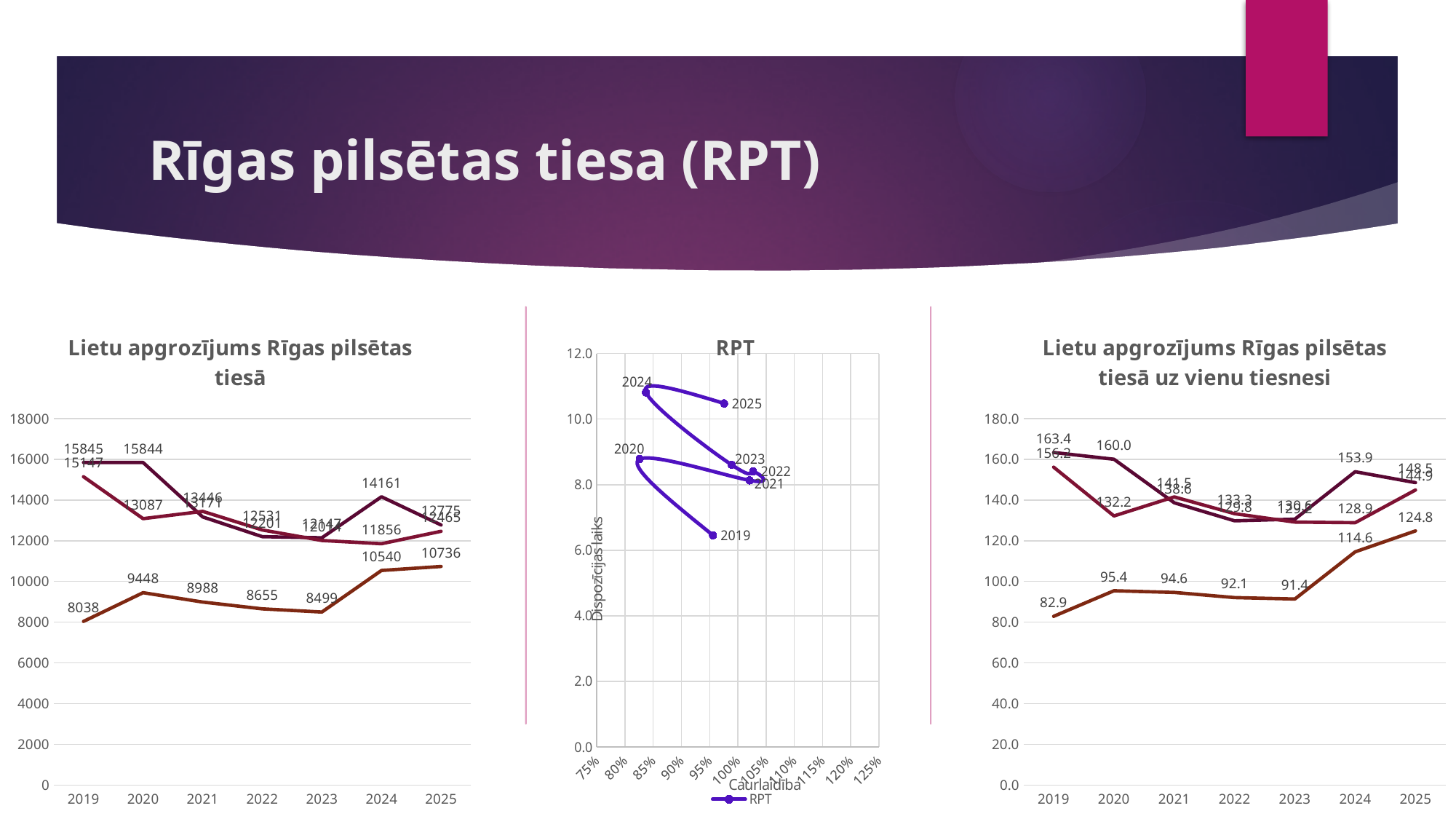
In the right chart 'Lietu apgrozījums Rīgas pilsētas tiesā uz vienu tiesnesi', what is the value of the lowest line in 2025? 124.8 In the middle chart 'RPT', which year has the lowest Dispozīcijas laiks value? 2019 In the right chart 'Lietu apgrozījums Rīgas pilsētas tiesā uz vienu tiesnesi', is the lowest line's value larger in 2019 or in 2020? 2020 How many series does the legend of the middle chart 'RPT' list? 1 In the left chart 'Lietu apgrozījums Rīgas pilsētas tiesā', by how much does the lowest line increase from 2024 to 2025? 196 What kind of chart is the left chart, 'Lietu apgrozījums Rīgas pilsētas tiesā'? line chart How many years are shown on the x axis of the left chart 'Lietu apgrozījums Rīgas pilsētas tiesā'? 7 In the left chart 'Lietu apgrozījums Rīgas pilsētas tiesā', what is the value of the lowest line in 2025? 10736 In the middle chart 'RPT', which year has the highest Dispozīcijas laiks value? 2024 In the left chart 'Lietu apgrozījums Rīgas pilsētas tiesā', what is the value of the lowest line in 2019? 8038 In the middle chart 'RPT', is the Dispozīcijas laiks value for 2019 greater or less than 8.0? less In the right chart 'Lietu apgrozījums Rīgas pilsētas tiesā uz vienu tiesnesi', what is the highest value labelled on the chart? 163.4